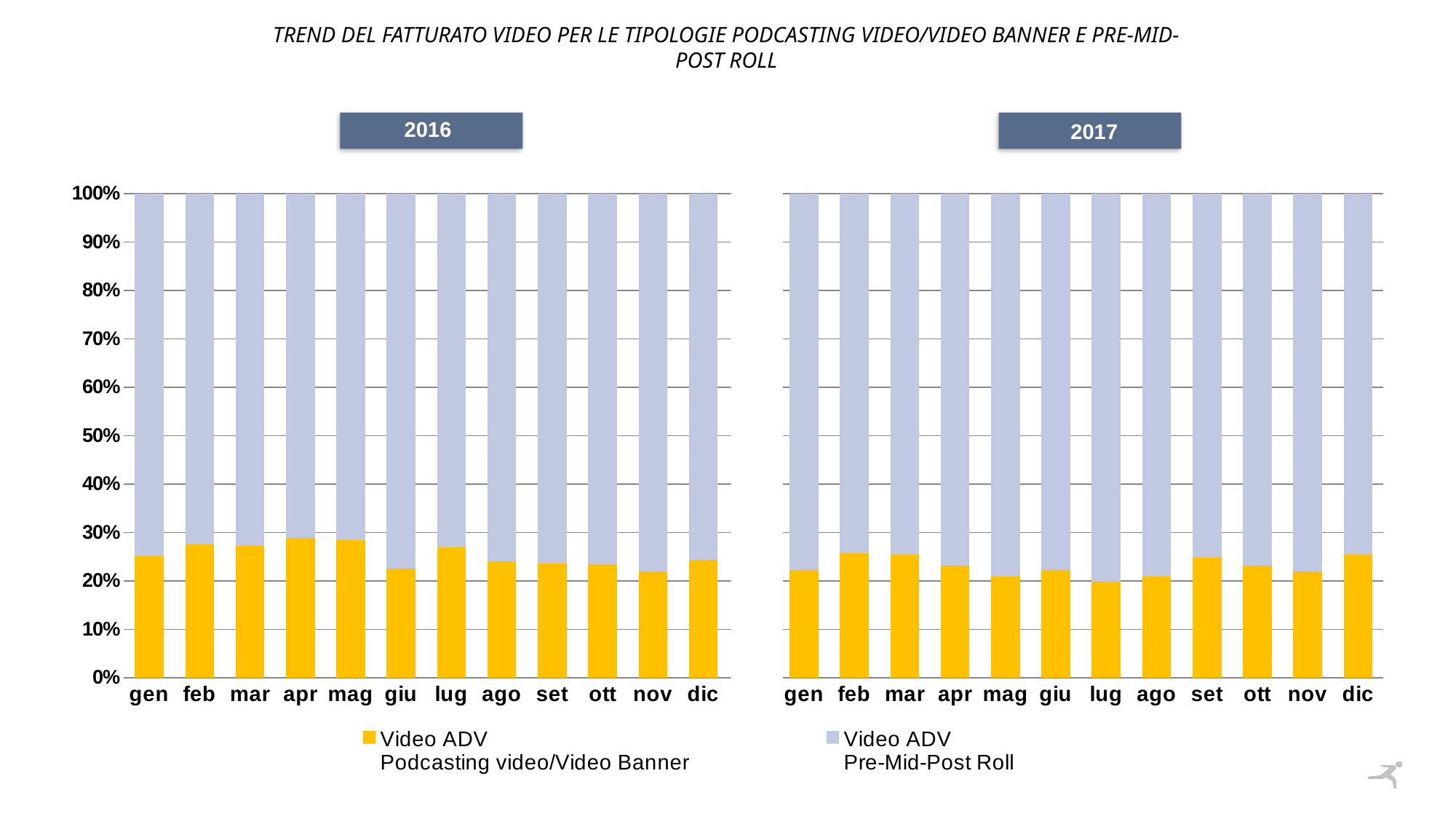
Which colour represents Video ADV Pre-Mid-Post Roll in the legend? light blue/lavender In the 2016 panel, which is larger, the Video ADV Podcasting video/Video Banner share for apr or for giu? apr In the 2017 panel, is the Video ADV Podcasting video/Video Banner share for mag greater or less than 30%? less What is the total of the stacked bar for gen in the 2016 panel? 100% In the 2017 panel, which month has the lowest Video ADV Podcasting video/Video Banner share? lug In the 2016 panel, is the Video ADV Podcasting video/Video Banner share for gen greater or less than 20%? greater How many series does the legend list? 2 How many months are plotted in the 2016 panel? 12 In the 2016 panel, is the Video ADV Pre-Mid-Post Roll share for apr greater or less than 60%? greater In the 2017 panel, which is larger, the Video ADV Podcasting video/Video Banner share for lug or for set? set What kind of chart is shown on the slide? stacked bar chart How many bars are plotted in total across the 2016 and 2017 panels? 24